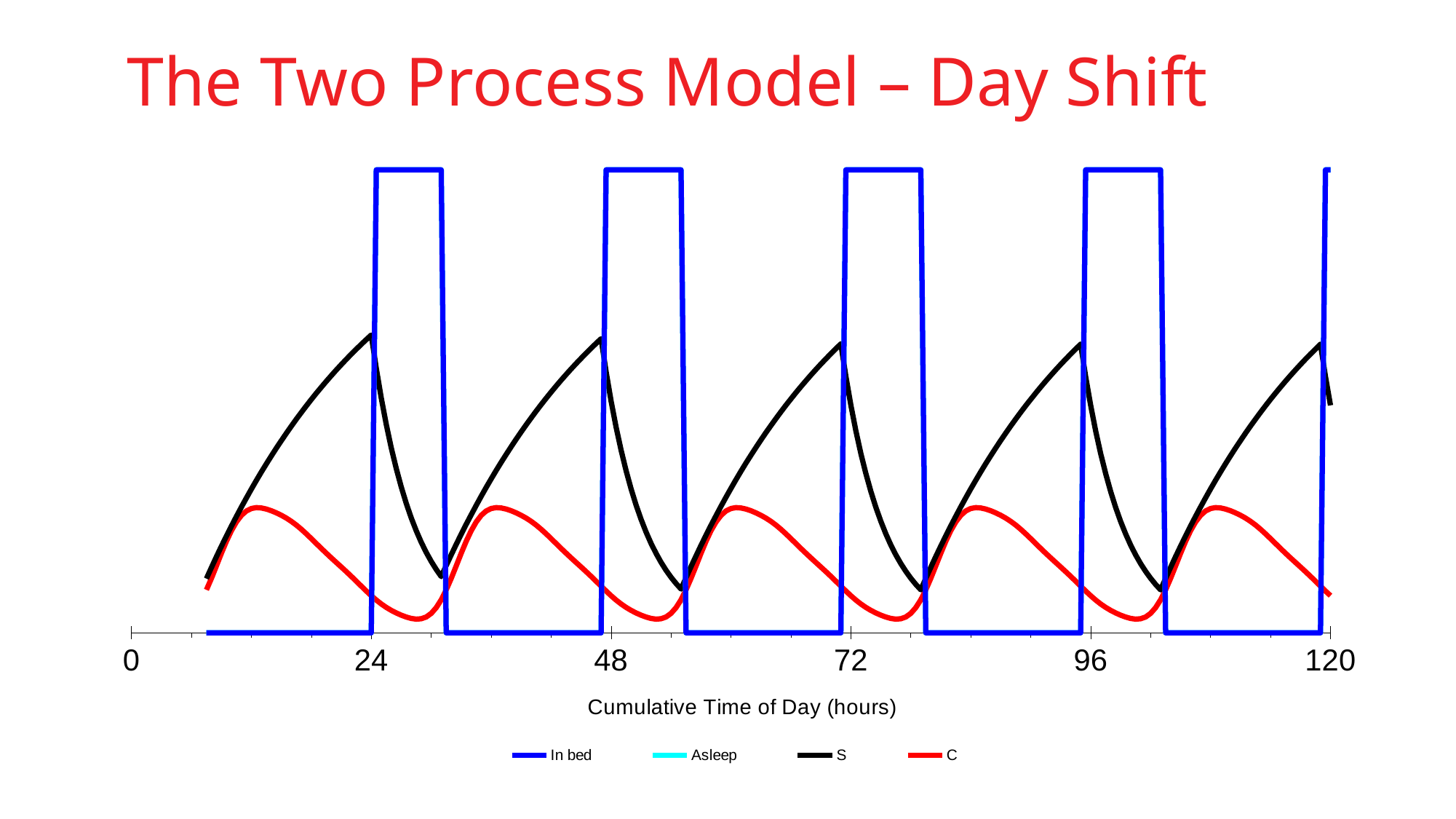
What is the highest tick value shown on the x axis? 120 Which series reaches the highest point on the chart? In bed Which series is drawn in blue? In bed What is the label of the x axis? Cumulative Time of Day (hours) How many series does the legend list? 4 At 24 hours, which is higher, the S curve or the C curve? S What is the title of the slide? The Two Process Model – Day Shift How many tick labels are shown on the x axis? 6 Just after 24 hours, does the S curve rise or fall? fall What kind of chart is shown on the slide? line chart Between 0 and 24 hours, does the S curve rise or fall? rise